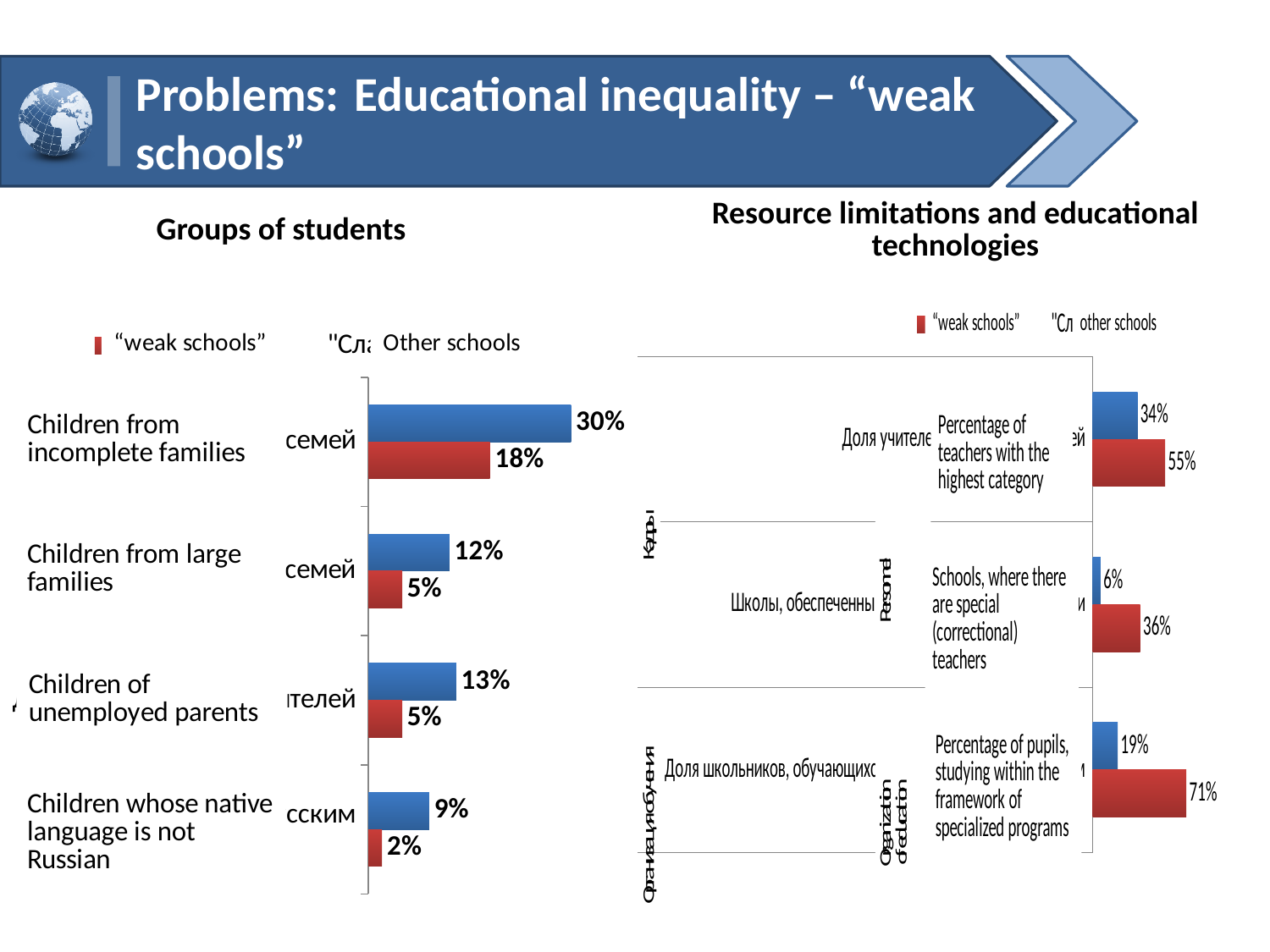
In the 'Resource limitations and educational technologies' chart, what is the difference between the 'weak schools' and 'Other schools' values for the percentage of teachers with the highest category? 21% In the 'Groups of students' chart, what kind of chart is used? Bar chart In the 'Groups of students' chart, how many categories are shown? 4 In the 'Groups of students' chart, which category has the lowest 'weak schools' value? Children whose native language is not Russian In the 'Groups of students' chart, what is the difference between the 'Other schools' and 'weak schools' values for children from large families? 7% In the 'Groups of students' chart, which category has the highest 'Other schools' value? Children from incomplete families How many series does the legend of the 'Resource limitations and educational technologies' chart list? 2